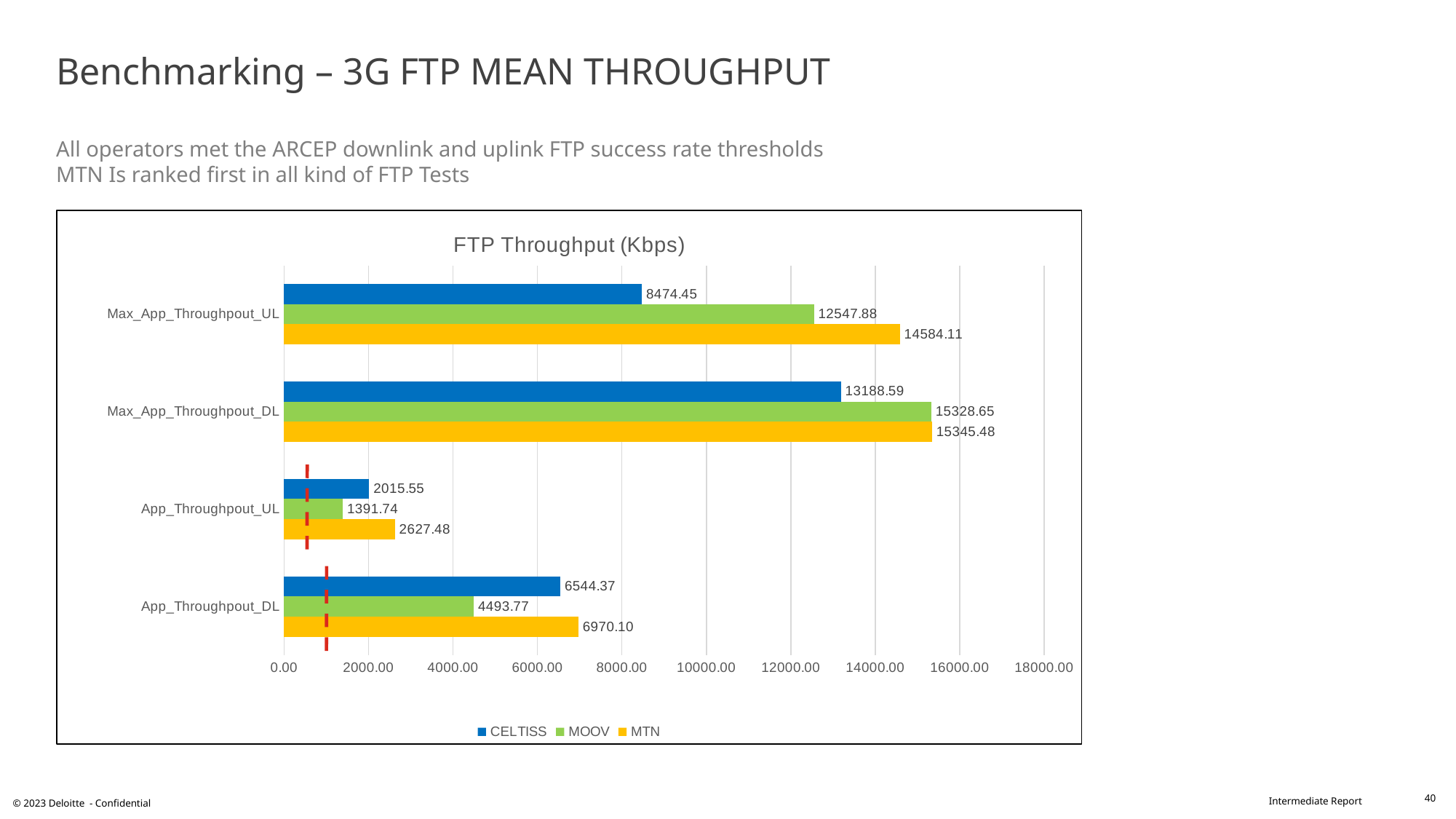
Which operator has the lowest value for App_Throughpout_UL? MOOV What type of chart is shown on the slide? bar chart What is the difference between the MTN and CELTISS values for Max_App_Throughpout_UL? 6109.66 What is the CELTISS value for App_Throughpout_DL? 6544.37 Which is larger for App_Throughpout_DL, the CELTISS value or the MOOV value? CELTISS What is the MTN value for Max_App_Throughpout_UL? 14584.11 Which operator has the highest value for Max_App_Throughpout_UL? MTN How many series does the legend list? 3 What is the title of the chart? FTP Throughput (Kbps) How many categories are shown on the chart? 4 What is the difference between the MTN and MOOV values for App_Throughpout_DL? 2476.33 What is the MOOV value for Max_App_Throughpout_DL? 15328.65